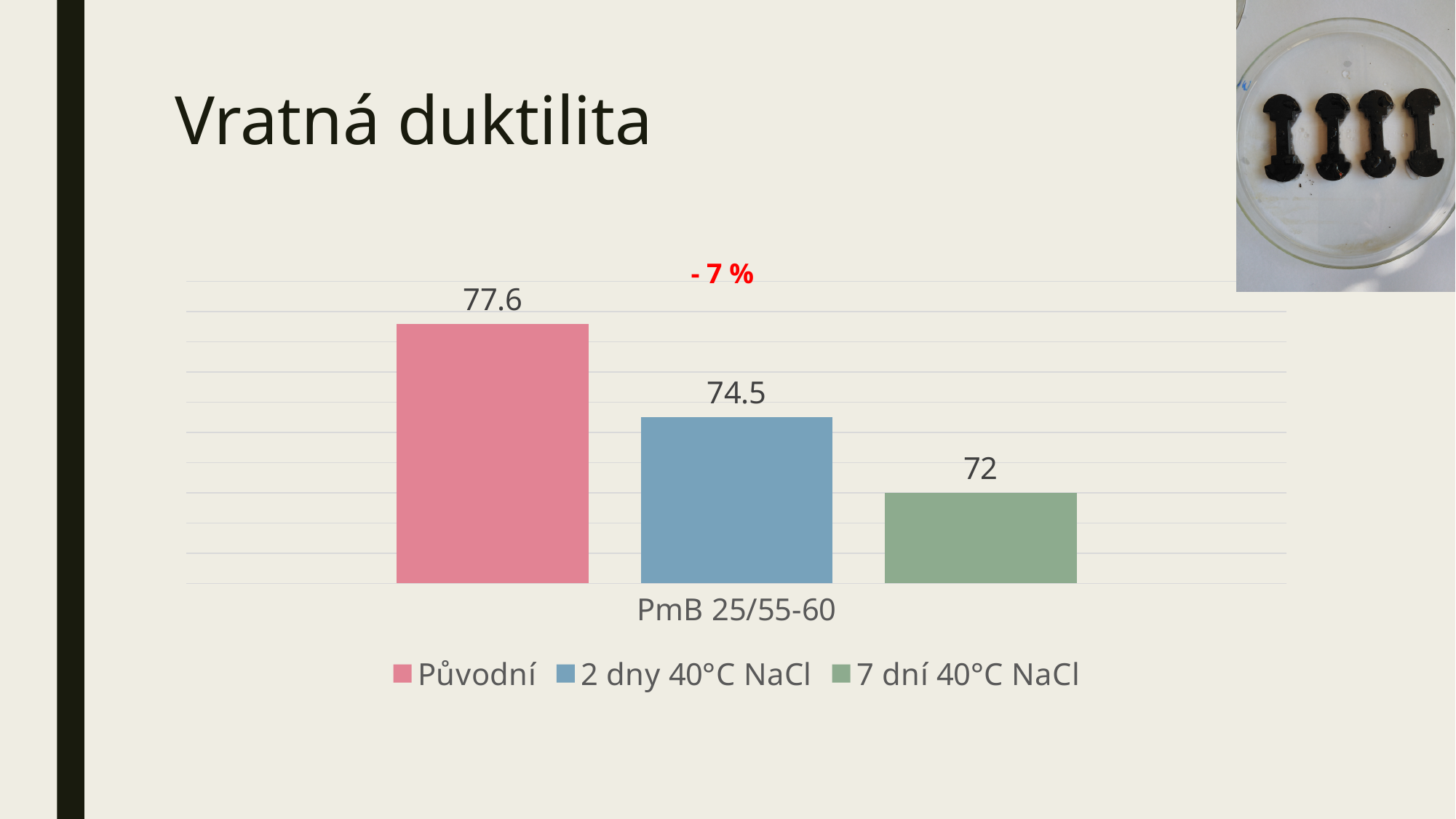
What is the difference between the Původní value and the 7 dní 40°C NaCl value? 5.6 How many series does the legend list? 3 Do the values rise or fall from left to right across the bars? Fall What is the category label shown on the x axis of the chart? PmB 25/55-60 Which series has the lowest value in the chart? 7 dní 40°C NaCl What kind of chart is shown on the slide? Bar chart Which is larger, the value for 2 dny 40°C NaCl or the value for 7 dní 40°C NaCl? 2 dny 40°C NaCl Which series has the highest value in the chart? Původní What is the value for Původní in the chart? 77.6 What is the difference between the Původní value and the 2 dny 40°C NaCl value? 3.1 What is the value for 2 dny 40°C NaCl in the chart? 74.5 What is the value for 7 dní 40°C NaCl in the chart? 72